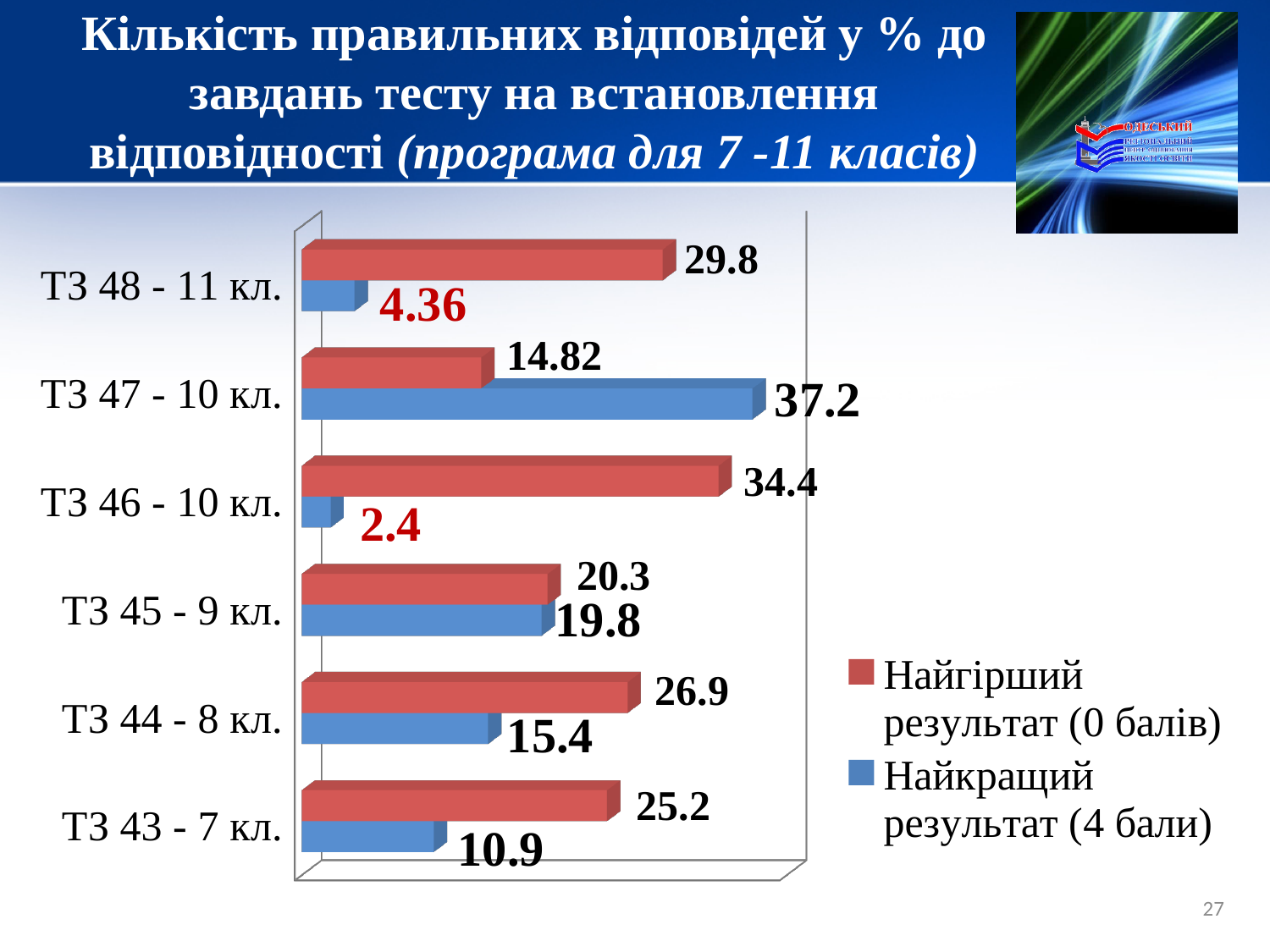
What is the value of the 'Найкращий результат (4 бали)' series for ТЗ 47 - 10 кл.? 37.2 How many categories are shown on the chart? 6 What is the difference between the 'Найгірший результат (0 балів)' and 'Найкращий результат (4 бали)' values for ТЗ 44 - 8 кл.? 11.5 Which category has the lowest value in the 'Найкращий результат (4 бали)' series? ТЗ 46 - 10 кл. Which colour represents the 'Найкращий результат (4 бали)' series? Blue What kind of chart is shown on the slide? Bar chart What is the value of the 'Найгірший результат (0 балів)' series for ТЗ 48 - 11 кл.? 29.8 Which category has the highest value in the 'Найгірший результат (0 балів)' series? ТЗ 46 - 10 кл. What is the value of the 'Найкращий результат (4 бали)' series for ТЗ 46 - 10 кл.? 2.4 How many series does the legend list? 2 For ТЗ 47 - 10 кл., which series has the larger value: 'Найгірший результат (0 балів)' or 'Найкращий результат (4 бали)'? Найкращий результат (4 бали) What is the value of the 'Найгірший результат (0 балів)' series for ТЗ 43 - 7 кл.? 25.2